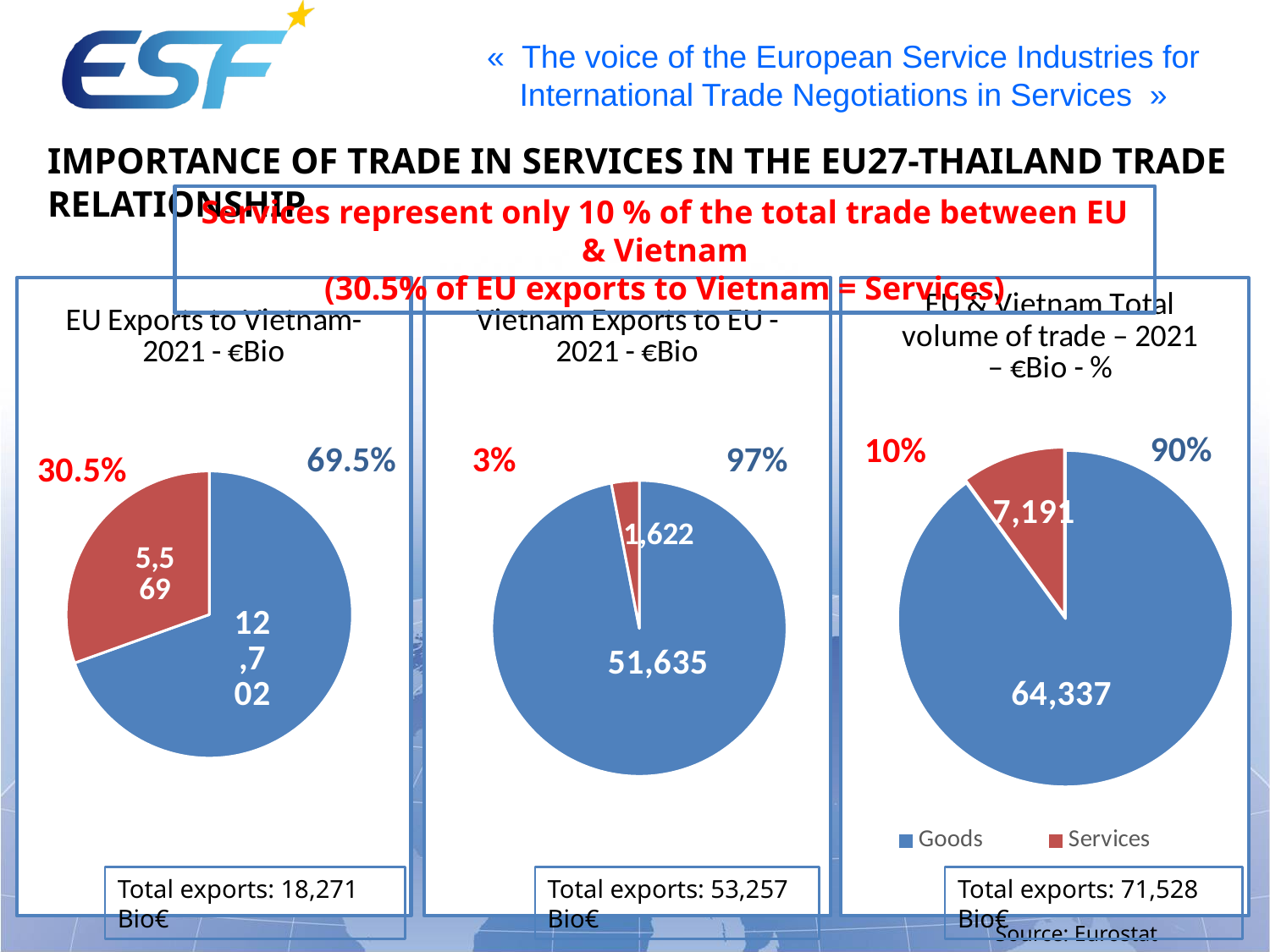
In the 'EU Exports to Vietnam - 2021 - €Bio' chart, what share of the pie is Services? 30.5% In the 'EU & Vietnam Total volume of trade – 2021' chart, what share of the pie is Services? 10% In the 'EU & Vietnam Total volume of trade – 2021' chart, what is the value for Goods? 64,337 Which colour represents Services in the pie charts? Red In the 'Vietnam Exports to EU - 2021 - €Bio' chart, which is larger, Goods or Services? Goods In the 'EU & Vietnam Total volume of trade – 2021' chart, which category is the largest? Goods What kind of chart is used on this slide? Pie chart In the 'EU & Vietnam Total volume of trade – 2021' chart, what is the value for Services? 7,191 In the 'Vietnam Exports to EU - 2021 - €Bio' chart, what share of the pie is Goods? 97% How many categories does the legend on the slide list? 2 In the 'Vietnam Exports to EU - 2021 - €Bio' chart, what is the value for Services? 1,622 In the 'Vietnam Exports to EU - 2021 - €Bio' chart, what is the value for Goods? 51,635